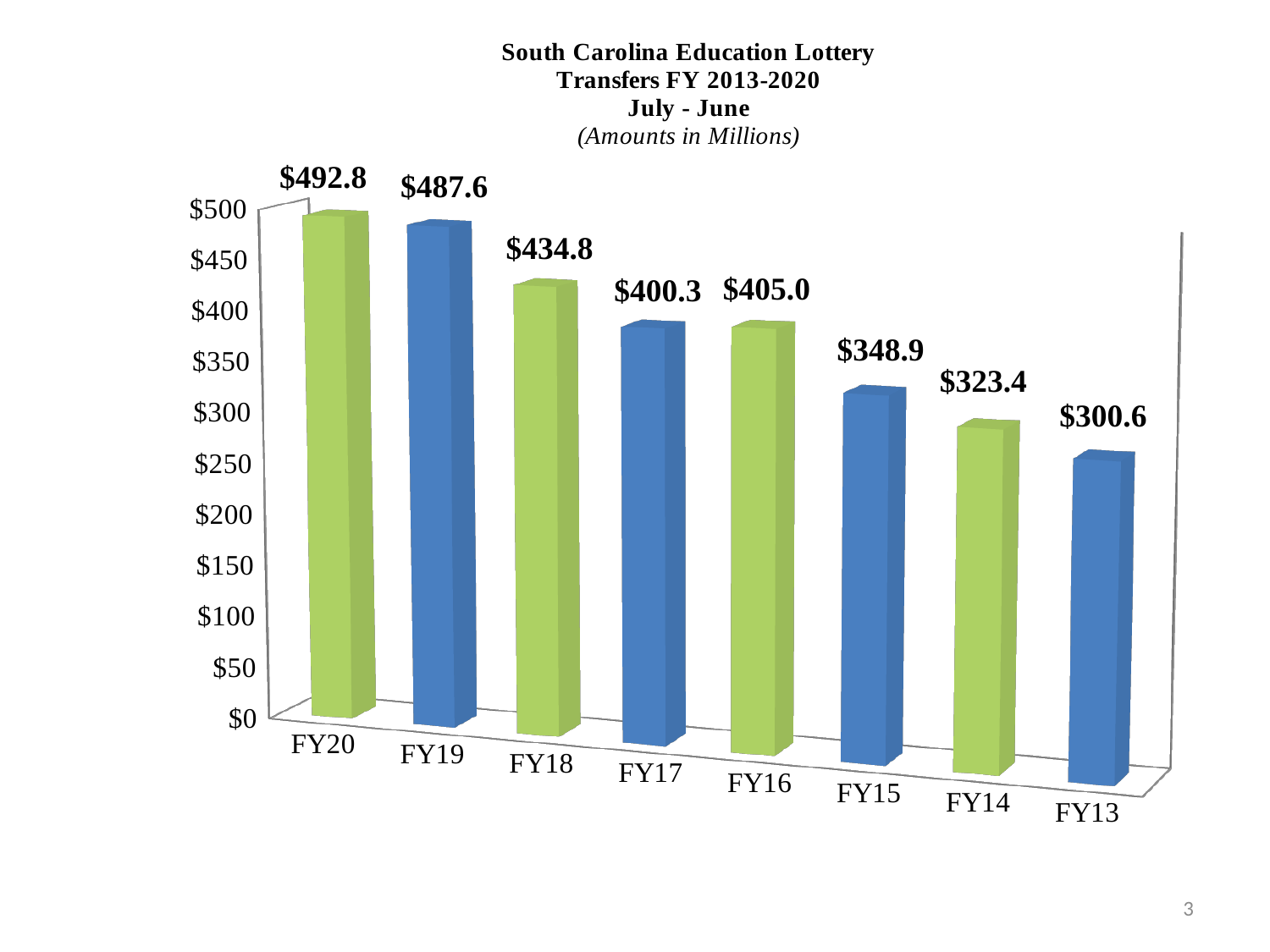
What is the value for FY16? $405.0 Which fiscal year has the highest value? FY20 Is the value for FY15 greater or less than $300? greater What kind of chart is shown on the slide? bar chart Which fiscal year has the lowest value? FY13 What is the value for FY20? $492.8 What is the title of the chart? South Carolina Education Lottery Transfers FY 2013-2020 July - June (Amounts in Millions) How many fiscal years are shown on the chart? 8 What is the value for FY13? $300.6 What is the difference between the values for FY20 and FY13? $192.2 What is the difference between the values for FY18 and FY17? $34.5 Which is larger, the value for FY17 or the value for FY16? FY16